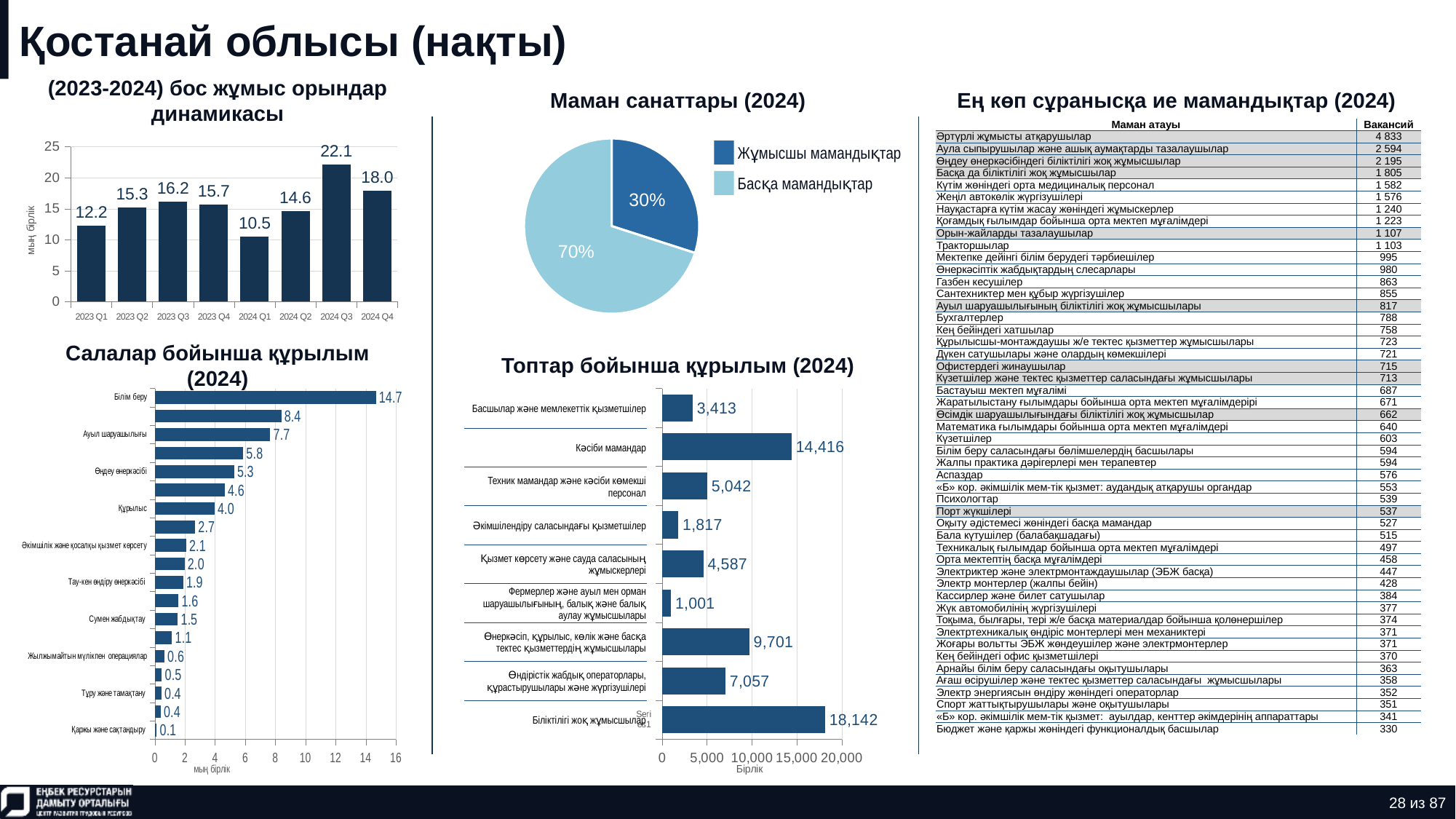
In the pie chart 'Маман санаттары (2024)', what share does 'Басқа мамандықтар' have? 70% In the chart 'Топтар бойынша құрылым (2024)', what is the value for 'Кәсіби мамандар'? 14,416 In the chart 'Салалар бойынша құрылым (2024)', which category has the lowest value? Қаржы және сақтандыру In the chart 'Топтар бойынша құрылым (2024)', which group has the highest value? Біліктілігі жоқ жұмысшылар In the pie chart 'Маман санаттары (2024)', how many categories does the legend list? 2 In the chart '(2023-2024) бос жұмыс орындар динамикасы', how many quarters are plotted? 8 In the chart '(2023-2024) бос жұмыс орындар динамикасы', what is the difference between 2024 Q3 and 2024 Q4? 4.1 In the chart '(2023-2024) бос жұмыс орындар динамикасы', which is larger: 2023 Q3 or 2023 Q4? 2023 Q3 What kind of chart is 'Топтар бойынша құрылым (2024)'? Bar chart In the chart '(2023-2024) бос жұмыс орындар динамикасы', what is the value for 2024 Q3? 22.1 In the chart '(2023-2024) бос жұмыс орындар динамикасы', which quarter has the lowest value? 2024 Q1 In the chart 'Салалар бойынша құрылым (2024)', what is the value for 'Білім беру'? 14.7